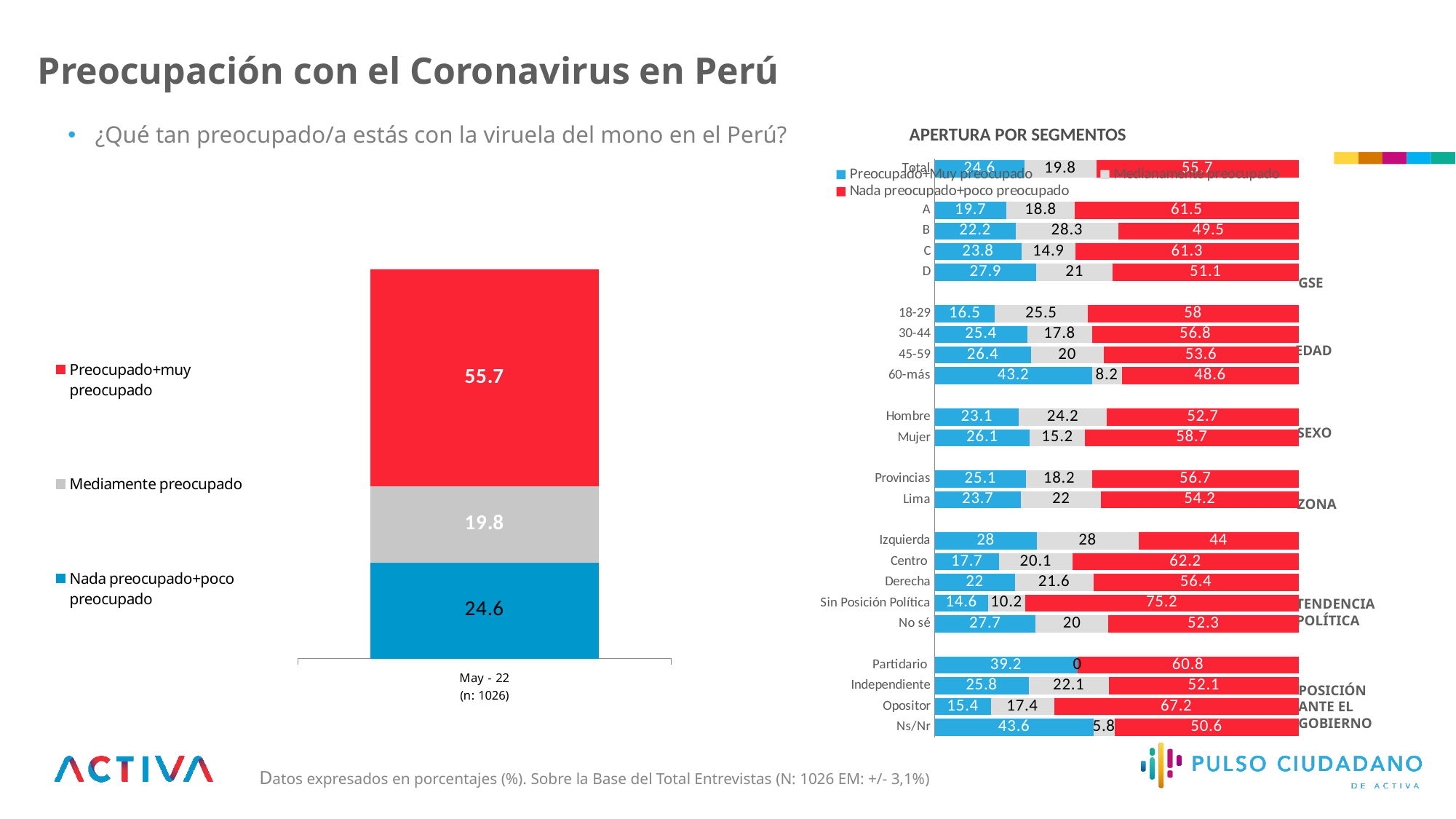
In the APERTURA POR SEGMENTOS chart, what is the difference between the red values for Opositor (67.2) and Independiente (52.1)? 15.1 In the APERTURA POR SEGMENTOS chart, what is the value of the red segment for Sin Posición Política? 75.2 In the APERTURA POR SEGMENTOS chart, what is the value of the grey segment for Partidario? 0 What kind of chart is the left chart for May - 22? Stacked bar chart In the left chart (May - 22), what is the value of the red segment labelled Preocupado+muy preocupado? 55.7 In the left chart, how many series does the legend list? 3 In the APERTURA POR SEGMENTOS chart, which segment (category) has the highest red value? Sin Posición Política In the APERTURA POR SEGMENTOS chart, what is the value of the blue segment for 60-más? 43.2 In the left chart (May - 22), what is the difference between the red segment (55.7) and the blue segment (24.6)? 31.1 In the left chart (May - 22), what is the value of the grey segment labelled Mediamente preocupado? 19.8 In the APERTURA POR SEGMENTOS chart, is the red value larger for Hombre or for Mujer? Mujer In the APERTURA POR SEGMENTOS chart, which segment has the lowest blue value? Sin Posición Política